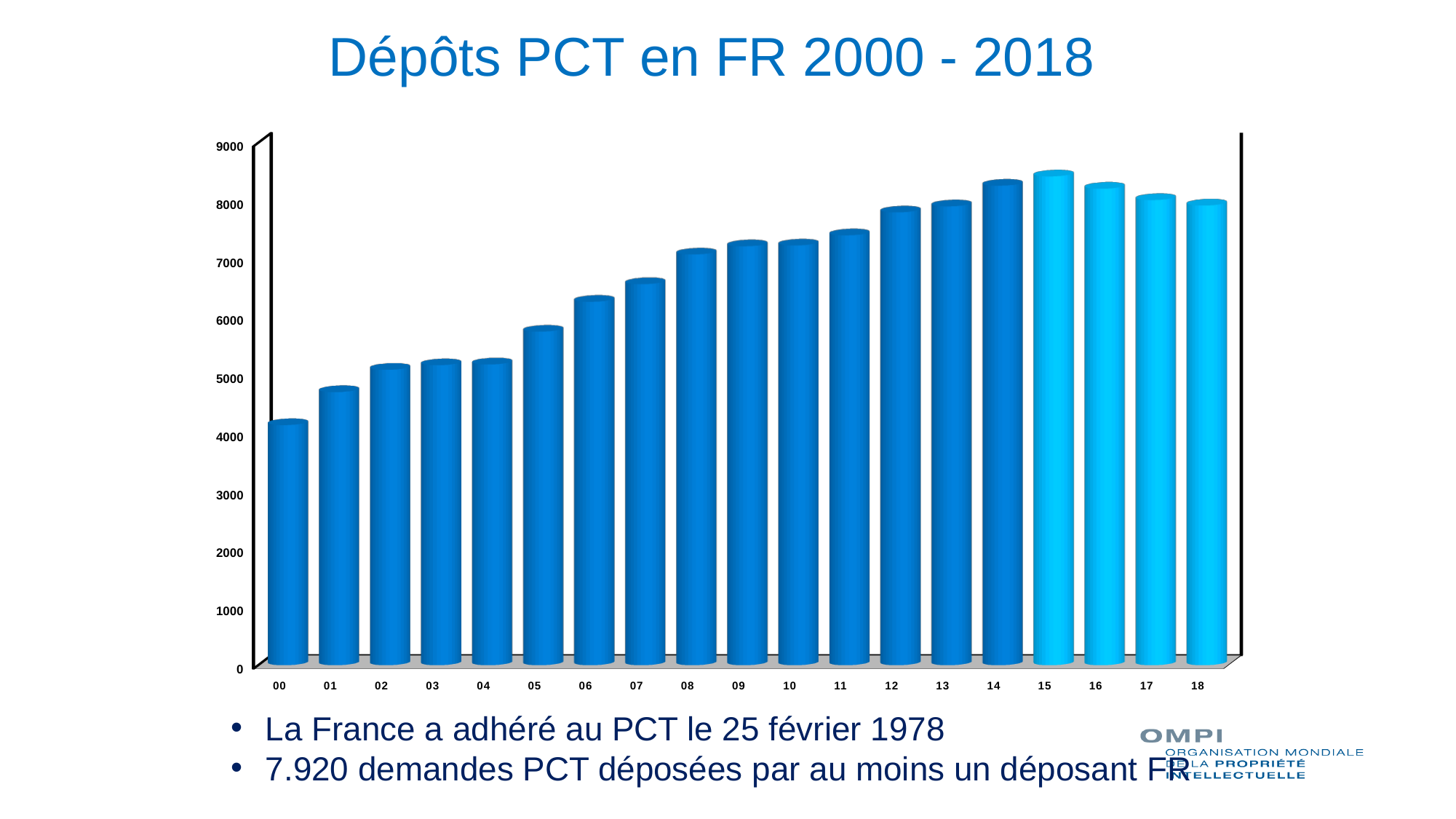
Which is larger, the value for 05 or the value for 10? 10 Is the value for 00 greater or less than 5000? less What kind of chart is shown on the slide? bar chart Which year has the highest bar? 15 Is the value for 15 greater or less than 8000? greater Is the value for 11 greater or less than 8000? less Do the values generally rise or fall from 00 to 14? rise What is the title of the chart? Dépôts PCT en FR 2000 - 2018 How many bars (years) are plotted in the chart? 19 Which year has the lowest bar? 00